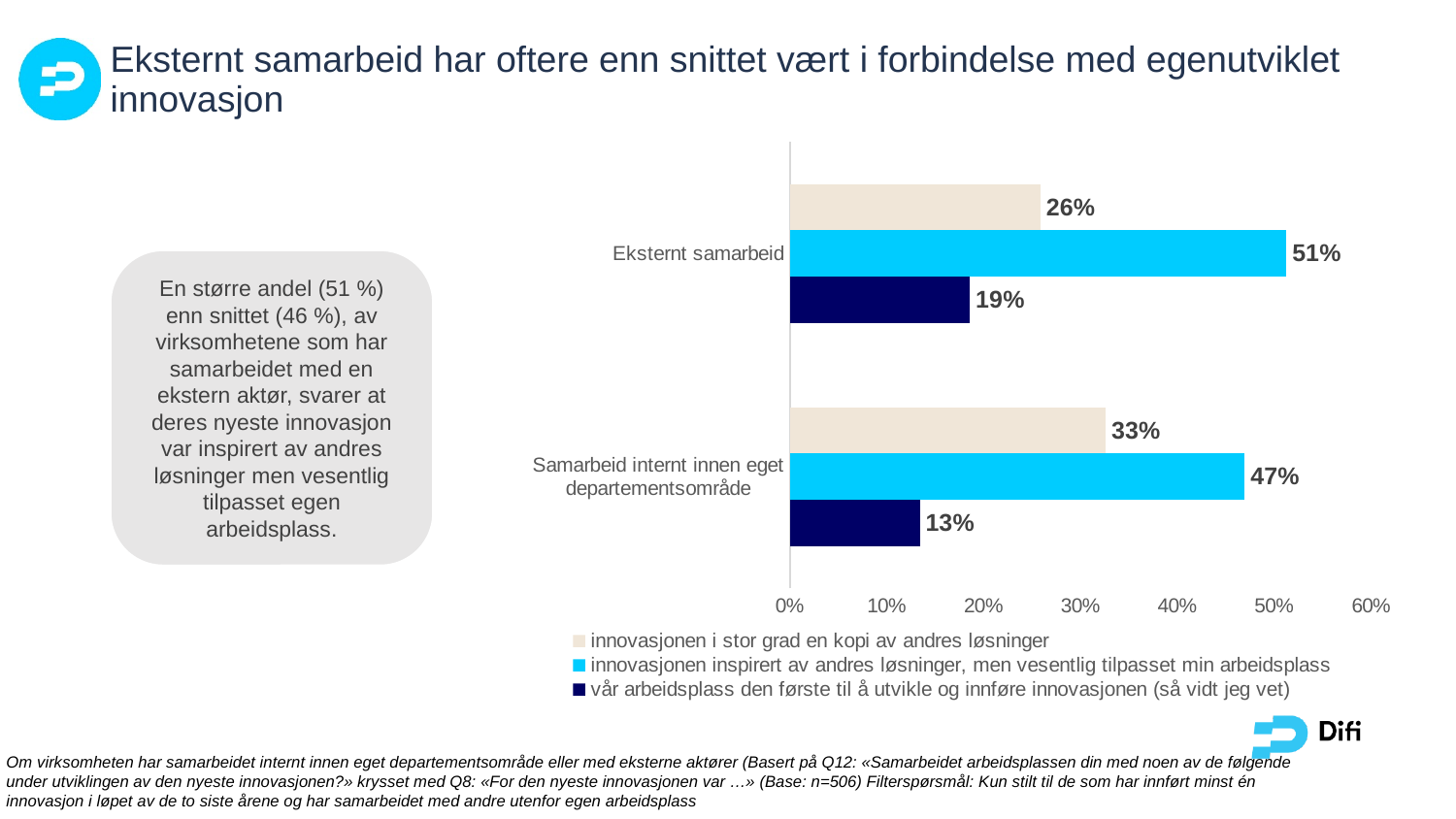
What is the difference between the 'innovasjonen inspirert av andres løsninger, men vesentlig tilpasset min arbeidsplass' values for 'Eksternt samarbeid' and 'Samarbeid internt innen eget departementsområde'? 4% What is the value for 'Eksternt samarbeid' in the series 'vår arbeidsplass den første til å utvikle og innføre innovasjonen (så vidt jeg vet)'? 19% What is the value for 'Samarbeid internt innen eget departementsområde' in the series 'innovasjonen i stor grad en kopi av andres løsninger'? 33% What is the value for 'Eksternt samarbeid' in the series 'innovasjonen inspirert av andres løsninger, men vesentlig tilpasset min arbeidsplass'? 51% Which category has the higher value for 'innovasjonen i stor grad en kopi av andres løsninger'? Samarbeid internt innen eget departementsområde What is the value for 'Samarbeid internt innen eget departementsområde' in the series 'vår arbeidsplass den første til å utvikle og innføre innovasjonen (så vidt jeg vet)'? 13% Which series has the highest value for 'Eksternt samarbeid'? innovasjonen inspirert av andres løsninger, men vesentlig tilpasset min arbeidsplass What kind of chart is shown on the slide? bar chart How many categories are shown on the chart? 2 What is the difference between the 'innovasjonen i stor grad en kopi av andres løsninger' values for 'Samarbeid internt innen eget departementsområde' and 'Eksternt samarbeid'? 7% Which series has the lowest value for 'Samarbeid internt innen eget departementsområde'? vår arbeidsplass den første til å utvikle og innføre innovasjonen (så vidt jeg vet) How many series does the legend list? 3